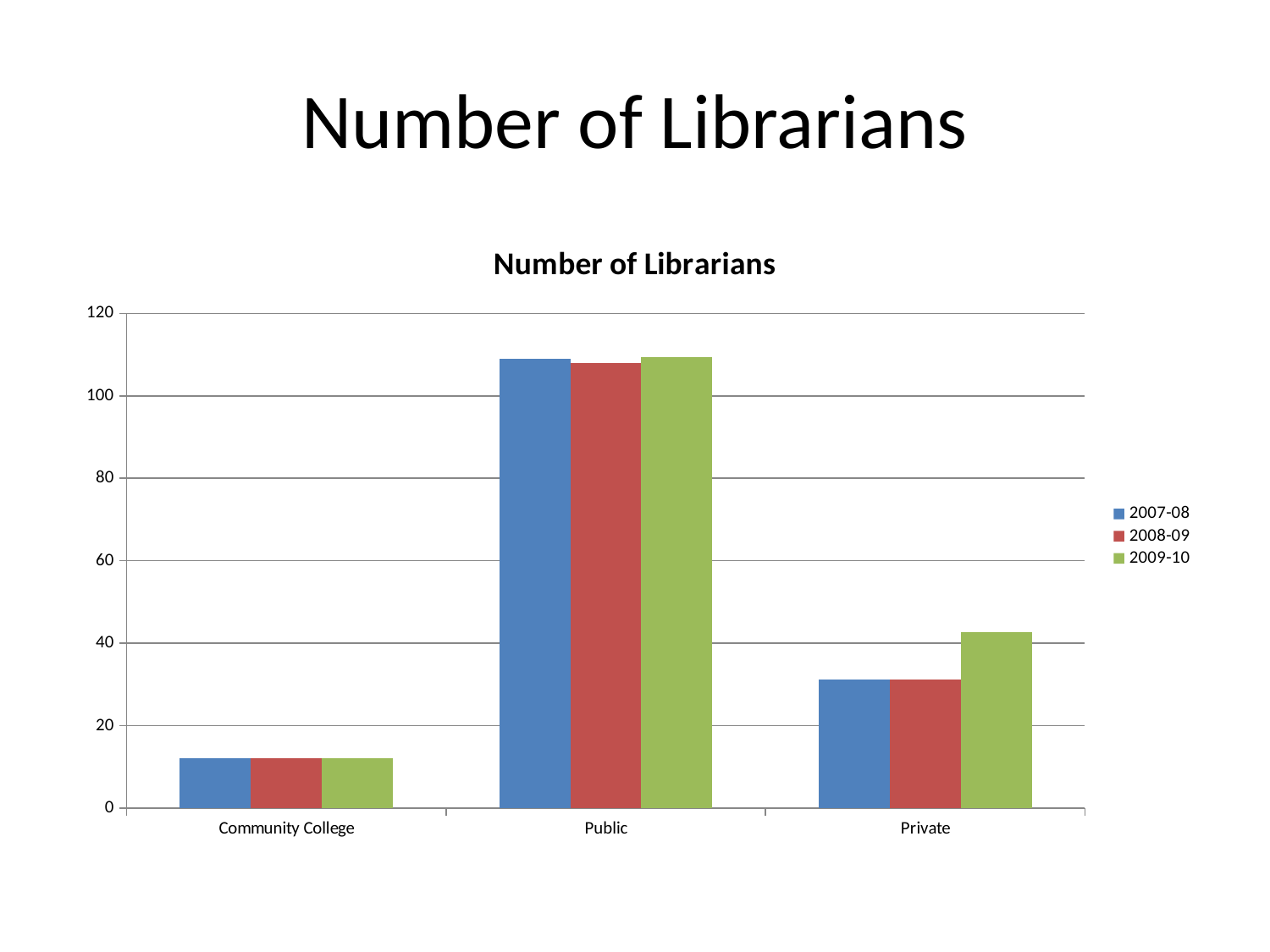
Which category has the lowest number of librarians? Community College What is the title of the chart? Number of Librarians Is the value for Public in 2007-08 greater or less than 100? greater Which series is shown in green in the legend? 2009-10 How many series does the legend list? 3 Is the value for Private in 2009-10 greater or less than 40? greater For Private, which is larger: the value for 2008-09 or the value for 2009-10? 2009-10 Is the value for Private in 2007-08 greater or less than 40? less How many categories are shown on the x axis? 3 Which category has the highest number of librarians? Public What kind of chart is shown on the slide? bar chart